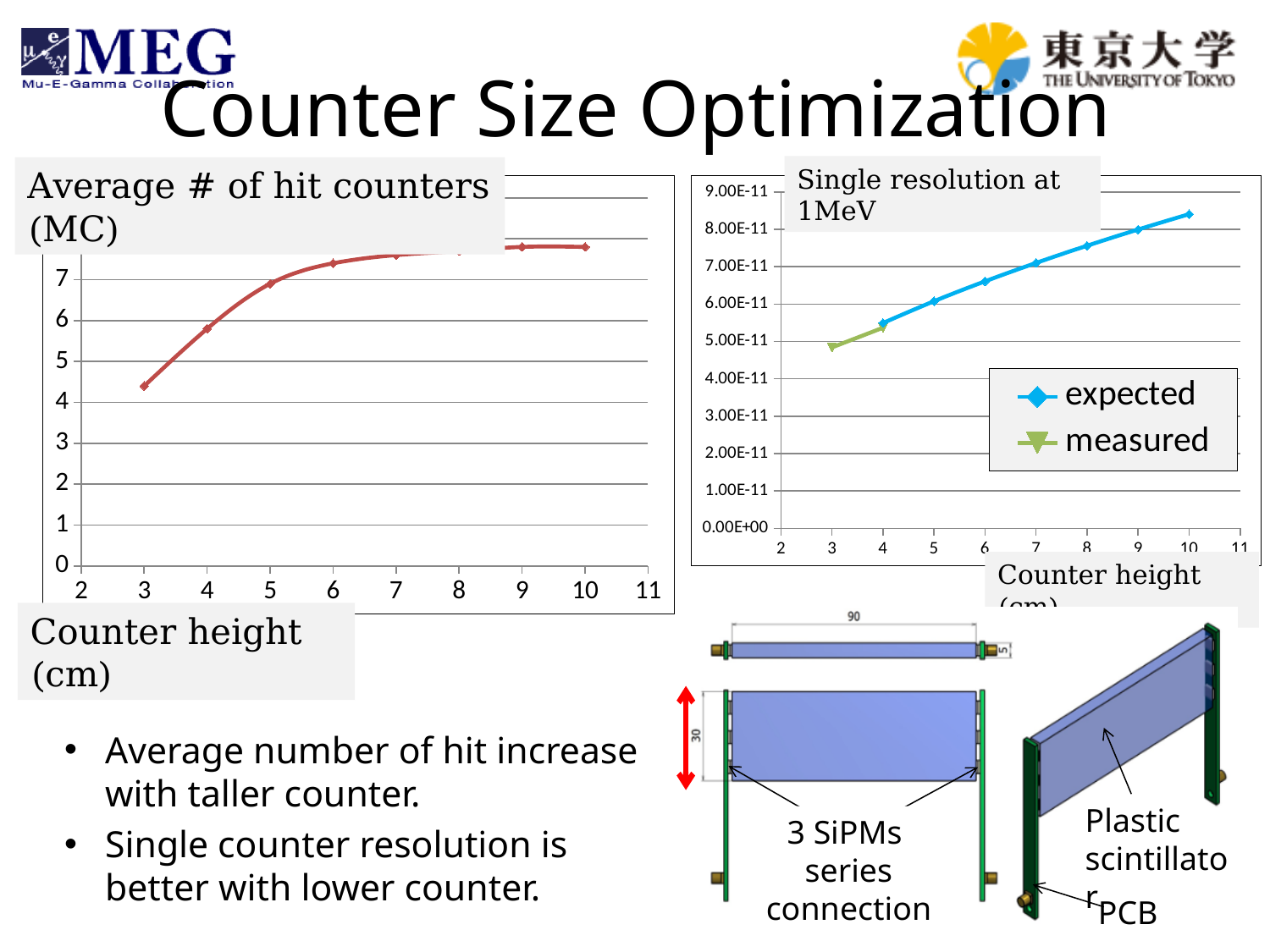
In the 'Single resolution at 1MeV' chart, what are the two series named in the legend? expected and measured In the 'Single resolution at 1MeV' chart, does the expected series rise or fall as counter height increases? rise In the 'Single resolution at 1MeV' chart, is the expected value at counter height 6 cm greater or less than 7.00E-11? less In the 'Single resolution at 1MeV' chart, is the expected value at counter height 10 cm greater or less than 8.00E-11? greater In the 'Single resolution at 1MeV' chart, at which counter height is the expected series highest? 10 In the 'Average # of hit counters (MC)' chart, is the value at counter height 10 cm greater or less than 7? greater What kind of chart is the 'Average # of hit counters (MC)' chart on the left? line chart In the 'Average # of hit counters (MC)' chart, do the values rise or fall as counter height increases? rise In the 'Average # of hit counters (MC)' chart, which is larger: the value at counter height 3 cm or at 6 cm? 6 cm How many series does the legend of the 'Single resolution at 1MeV' chart list? 2 In the 'Single resolution at 1MeV' chart, at which counter height is the expected series lowest? 4